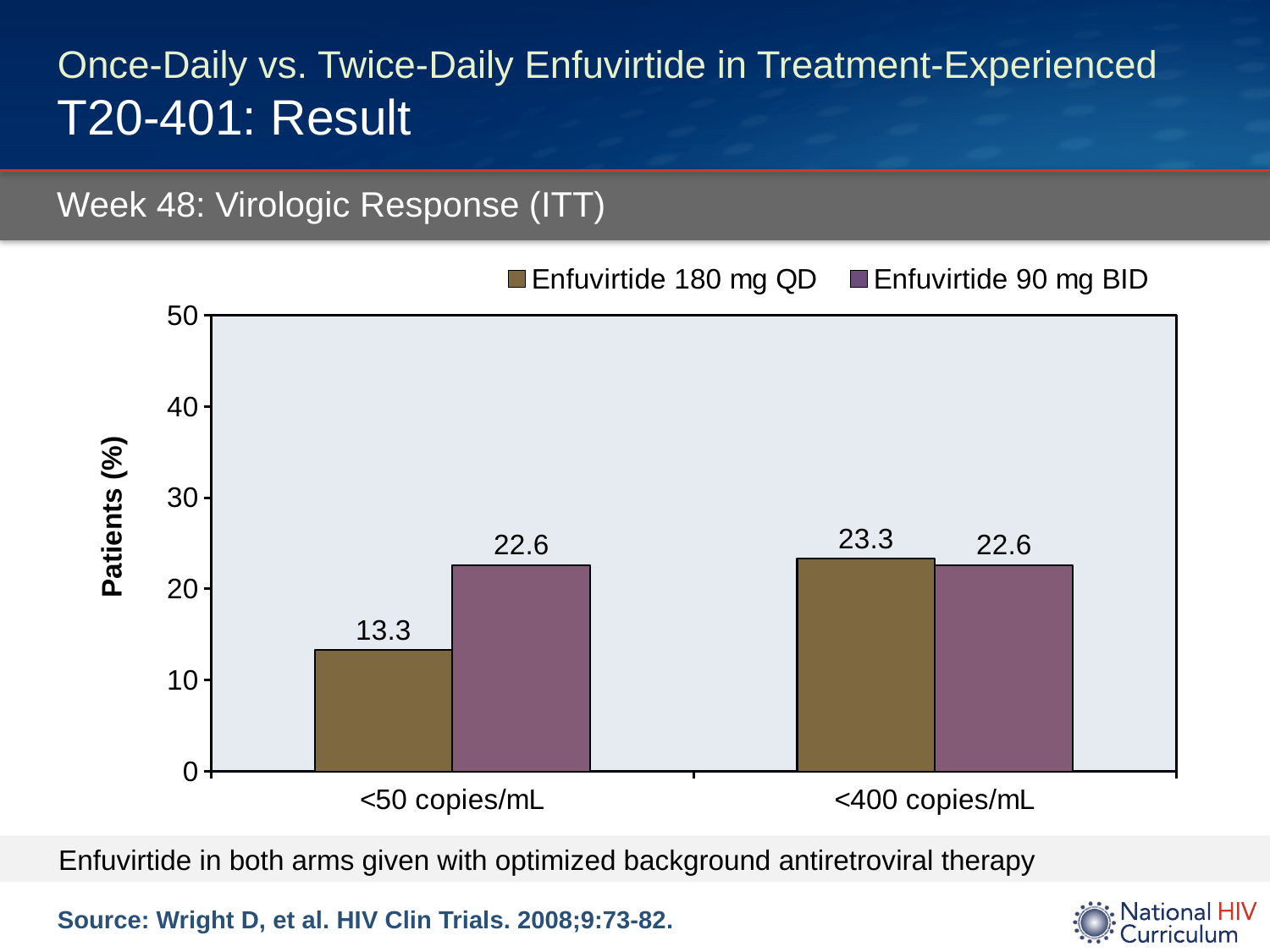
What is the difference between the Enfuvirtide 90 mg BID and Enfuvirtide 180 mg QD values for <50 copies/mL? 9.3 How many categories are shown on the x axis? 2 Which bar shows the lowest value on the chart? Enfuvirtide 180 mg QD, <50 copies/mL Is the value for Enfuvirtide 180 mg QD at <50 copies/mL greater or less than 20? less What is the label of the y axis? Patients (%) What percentage of patients in the Enfuvirtide 90 mg BID arm achieved <50 copies/mL? 22.6 How many series does the legend list? 2 What percentage of patients in the Enfuvirtide 180 mg QD arm achieved <50 copies/mL? 13.3 What percentage of patients in the Enfuvirtide 90 mg BID arm achieved <400 copies/mL? 22.6 What kind of chart is shown on the slide? Bar chart For <50 copies/mL, which arm has the higher percentage of patients: Enfuvirtide 180 mg QD or Enfuvirtide 90 mg BID? Enfuvirtide 90 mg BID What percentage of patients in the Enfuvirtide 180 mg QD arm achieved <400 copies/mL? 23.3